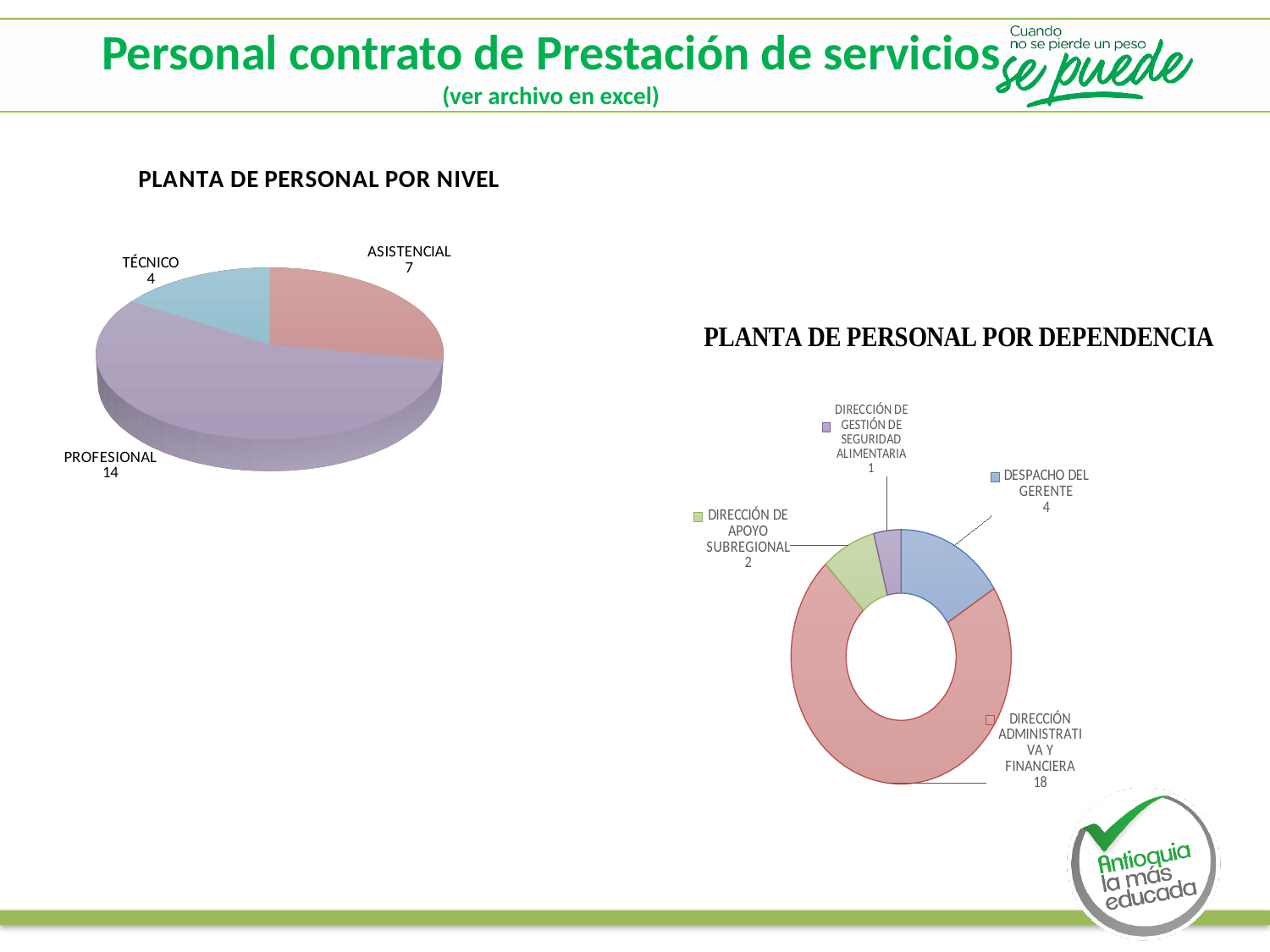
In the 'PLANTA DE PERSONAL POR DEPENDENCIA' chart, which is larger: DESPACHO DEL GERENTE or DIRECCIÓN DE APOYO SUBREGIONAL? DESPACHO DEL GERENTE In the 'PLANTA DE PERSONAL POR NIVEL' chart, what is the value for TÉCNICO? 4 In the 'PLANTA DE PERSONAL POR NIVEL' chart, how many categories are shown? 3 In the 'PLANTA DE PERSONAL POR NIVEL' chart, what is the difference between PROFESIONAL and ASISTENCIAL? 7 In the 'PLANTA DE PERSONAL POR DEPENDENCIA' chart, what is the value for DIRECCIÓN ADMINISTRATIVA Y FINANCIERA? 18 What kind of chart is 'PLANTA DE PERSONAL POR NIVEL'? Pie chart In the 'PLANTA DE PERSONAL POR DEPENDENCIA' chart, what share of the total does DIRECCIÓN ADMINISTRATIVA Y FINANCIERA represent? 72% In the 'PLANTA DE PERSONAL POR DEPENDENCIA' chart, what is the value for DESPACHO DEL GERENTE? 4 In the 'PLANTA DE PERSONAL POR DEPENDENCIA' chart, which category has the lowest value? DIRECCIÓN DE GESTIÓN DE SEGURIDAD ALIMENTARIA In the 'PLANTA DE PERSONAL POR NIVEL' chart, which category has the highest value? PROFESIONAL In the 'PLANTA DE PERSONAL POR NIVEL' chart, what is the value for PROFESIONAL? 14 In the 'PLANTA DE PERSONAL POR DEPENDENCIA' chart, how many categories are shown? 4